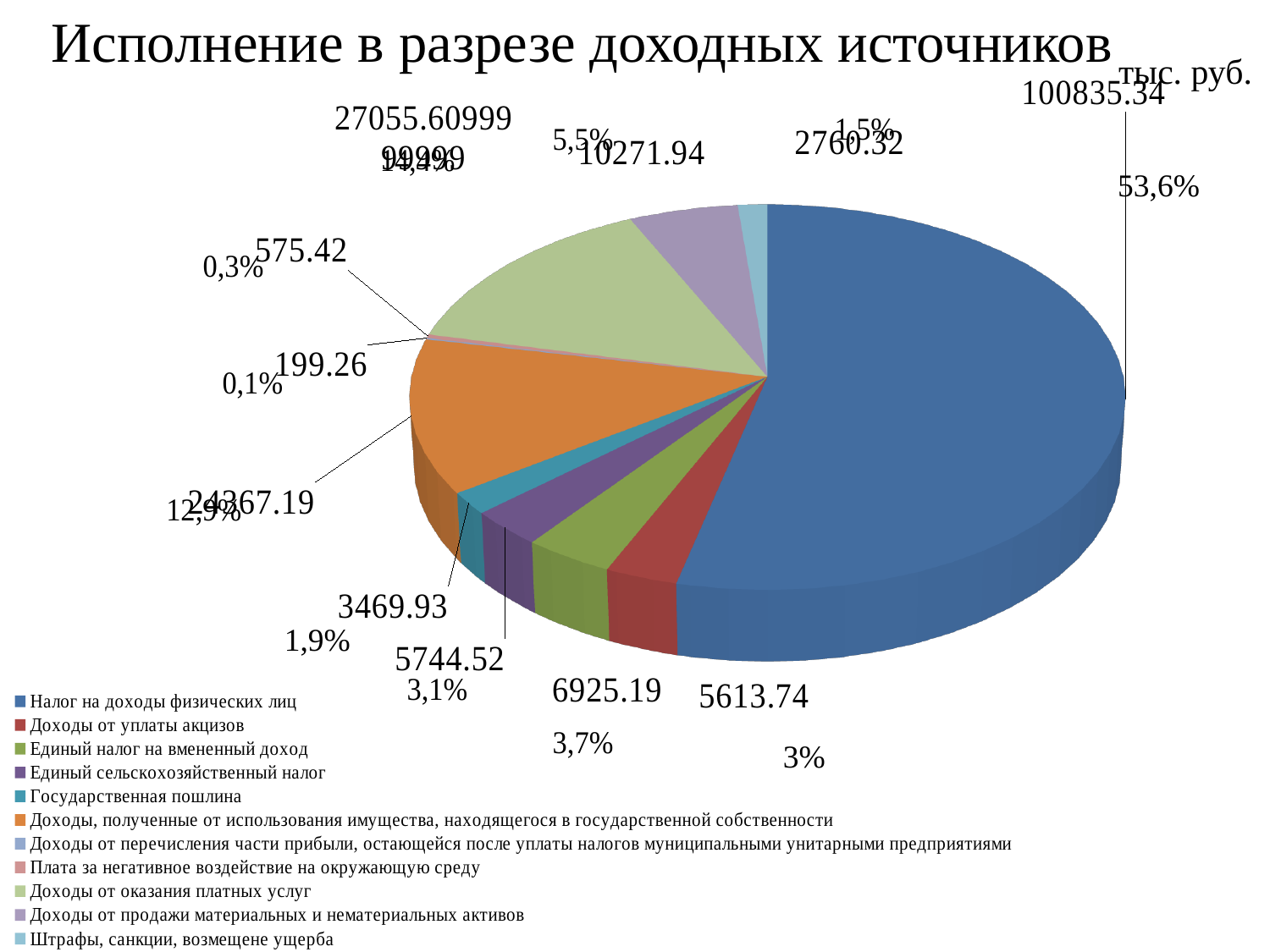
What is the value shown for Государственная пошлина? 3469.93 What is the difference between the values for Единый налог на вмененный доход and Доходы от уплаты акцизов? 1311.45 What share of the pie does Штрафы, санкции, возмещене ущерба account for? 1,5% Which is larger: Единый налог на вмененный доход or Единый сельскохозяйственный налог? Единый налог на вмененный доход What share of the pie does Налог на доходы физических лиц account for? 53,6% What is the value shown for Доходы от уплаты акцизов? 5613.74 Which category has the largest slice of the pie? Налог на доходы физических лиц In what units are the values on the chart given, according to the slide? тыс. руб. What is the value shown for Налог на доходы физических лиц? 100835.34 Which category has the smallest slice of the pie? Доходы от перечисления части прибыли, остающейся после уплаты налогов муниципальными унитарными предприятиями What kind of chart is shown on the slide? pie chart How many categories does the legend of the pie chart list? 11